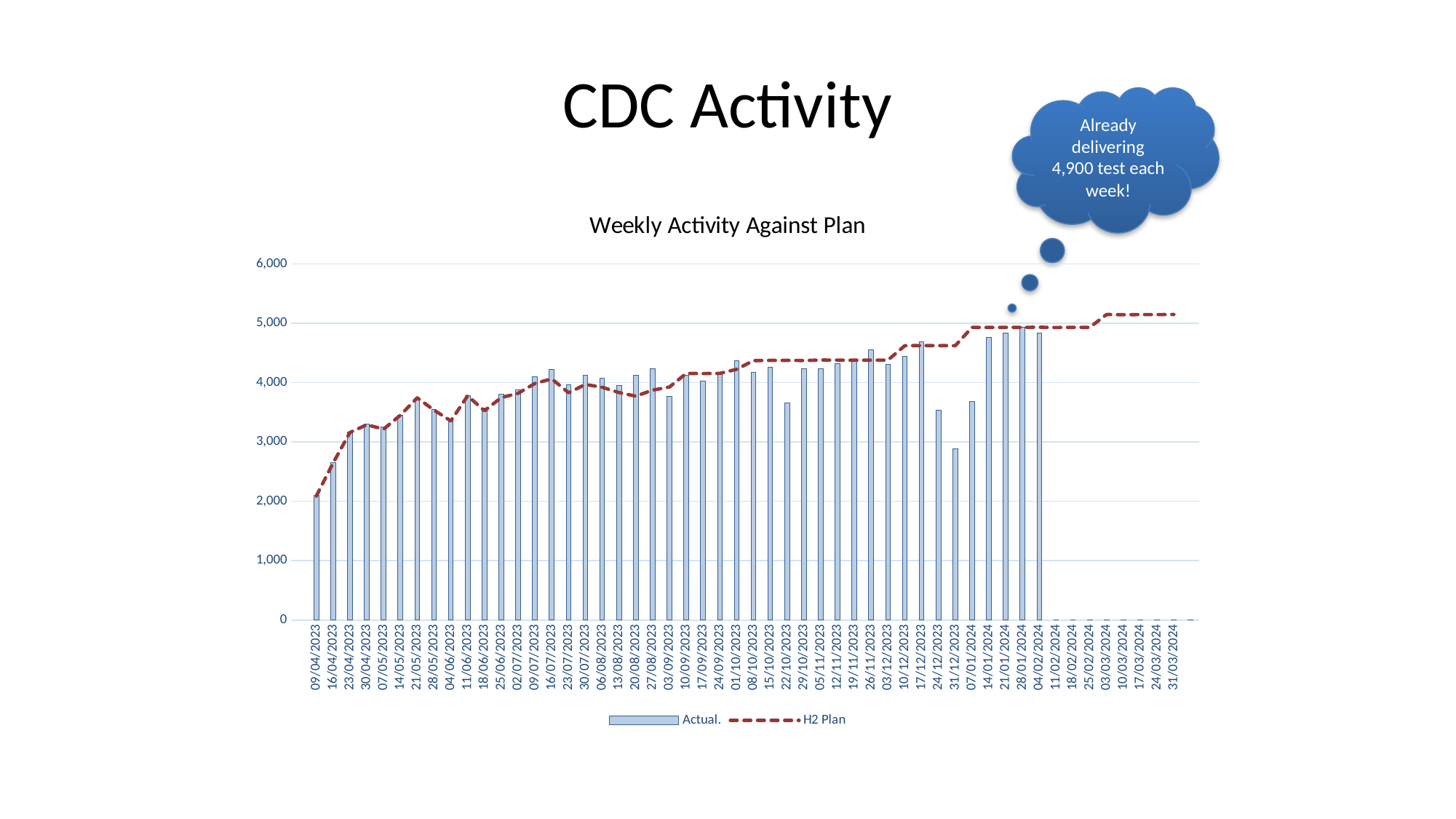
What are the two series named in the legend of the chart? Actual. and H2 Plan Is the Actual value for 09/04/2023 greater or less than 3,000? less Which week has the larger Actual bar, 15/10/2023 or 22/10/2023? 15/10/2023 How is the H2 Plan series drawn on the chart? As a dashed red line What kind of chart is shown under the title 'Weekly Activity Against Plan'? Bar chart (with a dashed plan line) Is the Actual value for 22/10/2023 greater or less than 4,000? less Is the Actual value for 24/12/2023 greater or less than 3,000? greater Does the H2 Plan line generally rise or fall from 09/04/2023 to 31/03/2024? Rise Which week has the lowest Actual bar on the chart? 09/04/2023 Which week has the larger Actual bar, 31/12/2023 or 07/01/2024? 07/01/2024 How many series does the legend of the 'Weekly Activity Against Plan' chart list? 2